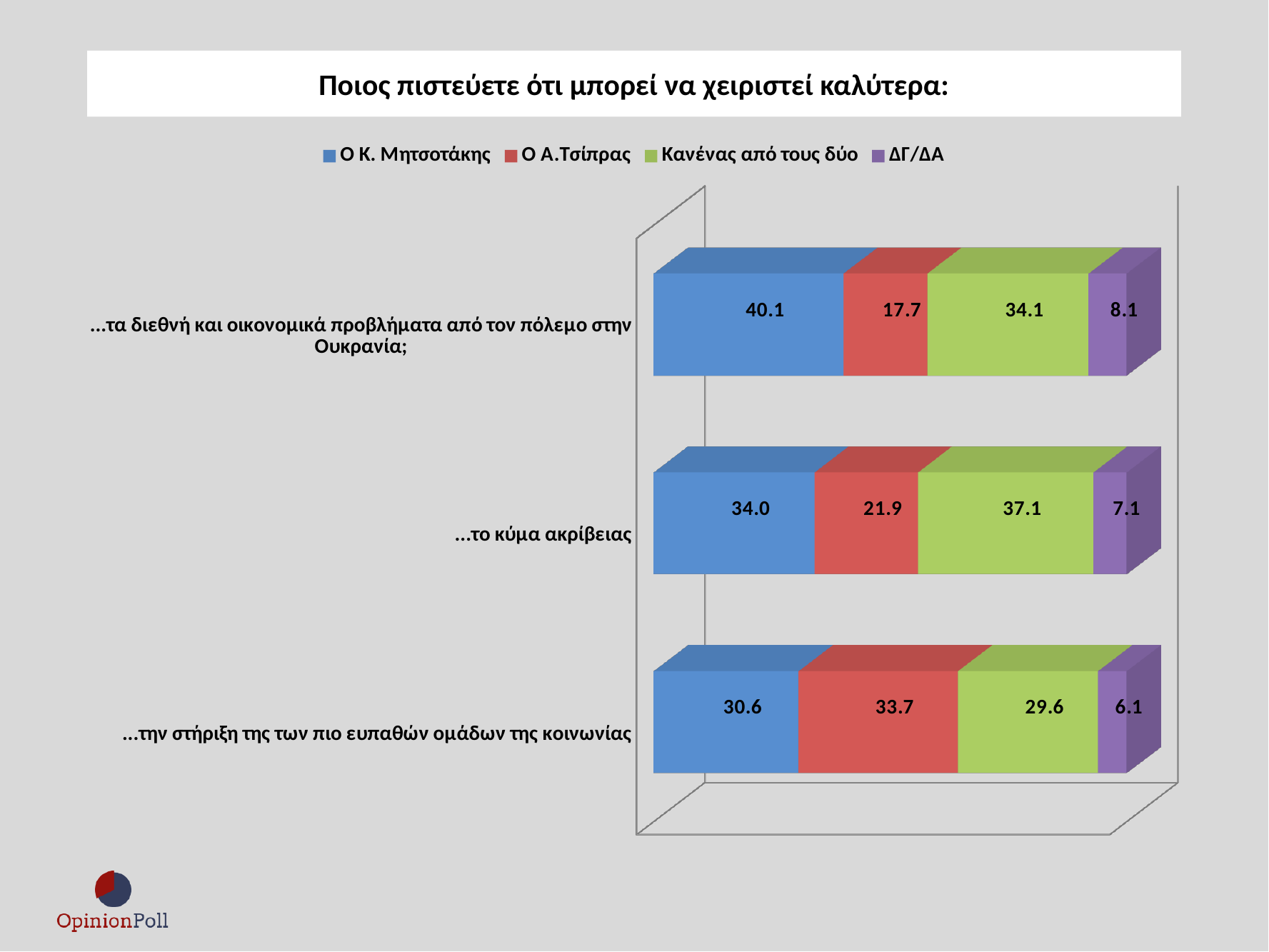
What is the value for Ο Κ. Μητσοτάκης in the category about the international and economic problems from the war in Ukraine ("...τα διεθνή και οικονομικά προβλήματα από τον πόλεμο στην Ουκρανία;")? 40.1 What kind of chart is shown on the slide? Stacked bar chart What is the total of the stacked bar for "...το κύμα ακρίβειας"? 100.1 What is the value for Κανένας από τους δύο in the category "...το κύμα ακρίβειας"? 37.1 How many categories (bars) does the chart show? 3 In which category does Ο Κ. Μητσοτάκης have the highest value? ...τα διεθνή και οικονομικά προβλήματα από τον πόλεμο στην Ουκρανία; How many series does the legend list? 4 What is the value for Ο Α.Τσίπρας in the category "...το κύμα ακρίβειας"? 21.9 In the category "...την στήριξη της των πιο ευπαθών ομάδων της κοινωνίας", which is larger: the value for Ο Κ. Μητσοτάκης or for Ο Α.Τσίπρας? Ο Α.Τσίπρας What is the difference between the values for Ο Κ. Μητσοτάκης and Ο Α.Τσίπρας in the category "...τα διεθνή και οικονομικά προβλήματα από τον πόλεμο στην Ουκρανία;"? 22.4 What is the value for ΔΓ/ΔΑ in the category "...την στήριξη της των πιο ευπαθών ομάδων της κοινωνίας"? 6.1 In which category does Ο Α.Τσίπρας have the lowest value? ...τα διεθνή και οικονομικά προβλήματα από τον πόλεμο στην Ουκρανία;